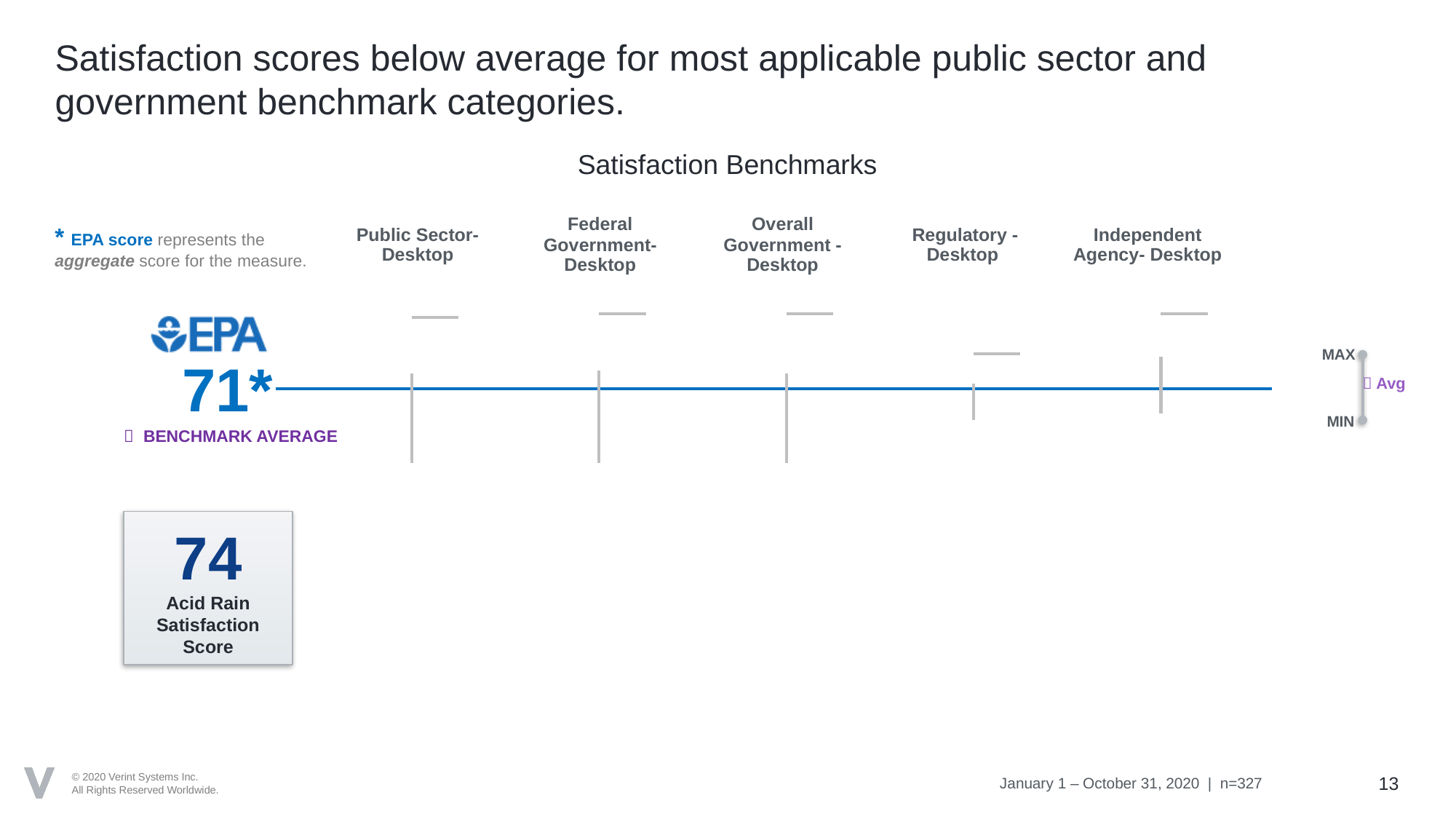
Which is larger, the Acid Rain Satisfaction Score or the EPA score? Acid Rain Satisfaction Score What three labels does the key on the right of the Satisfaction Benchmarks chart show? MAX, Avg, MIN What is the difference between the Acid Rain Satisfaction Score and the EPA score? 3 What is the EPA score shown on the Satisfaction Benchmarks chart? 71 What is the Acid Rain Satisfaction Score shown on the slide? 74 How many benchmark categories are shown in the Satisfaction Benchmarks chart? 5 What is the title of the chart on the slide? Satisfaction Benchmarks Which benchmark category has the lowest average marker in the Satisfaction Benchmarks chart? Regulatory - Desktop Is the EPA score of 71 above or below the Public Sector-Desktop benchmark average marker? below